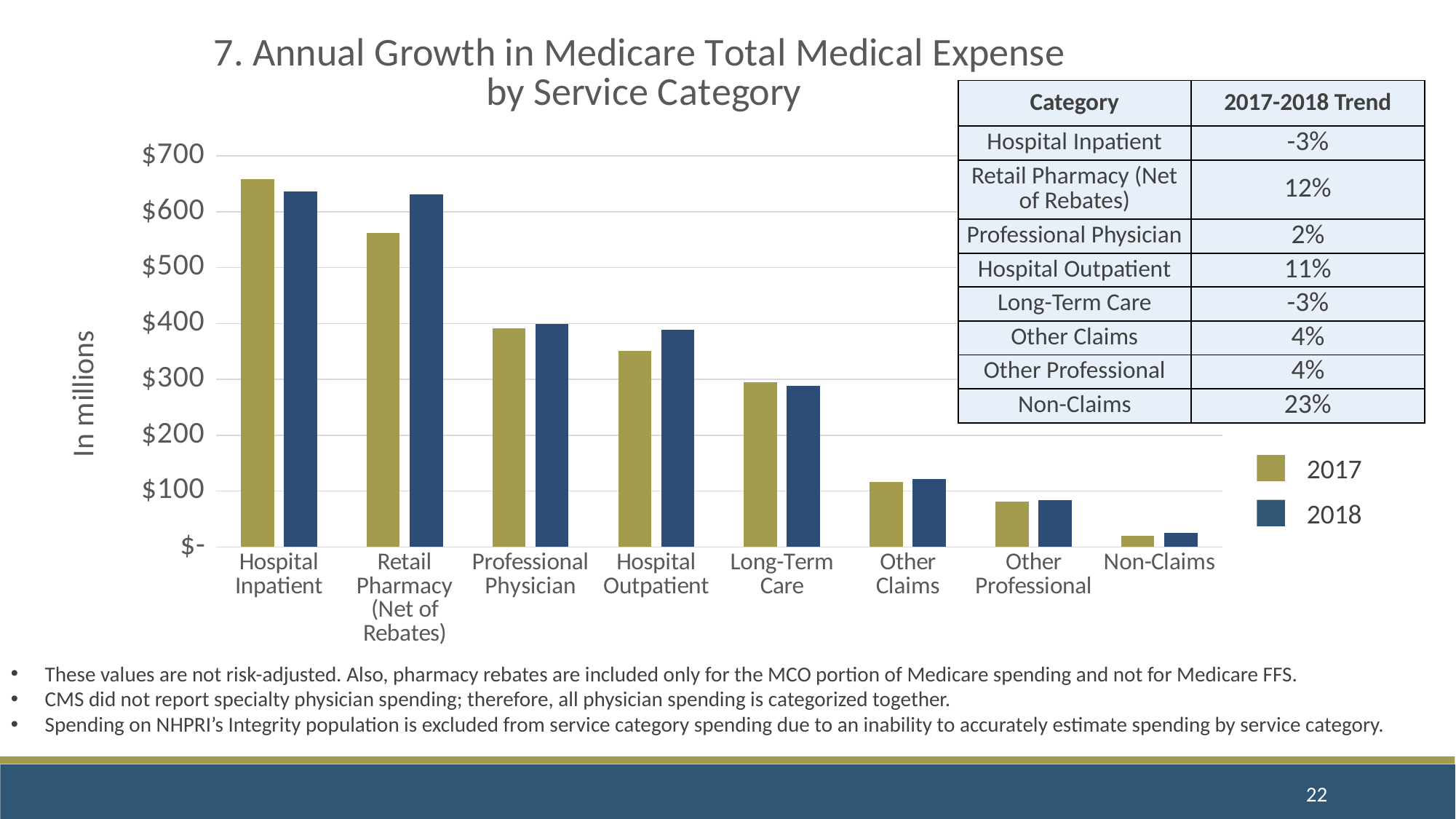
Is the 2017 value for Hospital Inpatient greater or less than $600? greater How many service categories are shown on the x axis of the chart? 8 Is the 2017 value for Retail Pharmacy (Net of Rebates) greater or less than $600? less For Retail Pharmacy (Net of Rebates), which year has the larger value, 2017 or 2018? 2018 For Hospital Inpatient, which year has the larger value, 2017 or 2018? 2017 Is the 2017 value for Hospital Outpatient greater or less than $400? less What kind of chart is shown on the slide? bar chart Which service category has the highest 2017 value in the chart? Hospital Inpatient How many series does the legend list? 2 Which service category has the lowest 2018 value in the chart? Non-Claims What is the label on the vertical axis of the chart? In millions